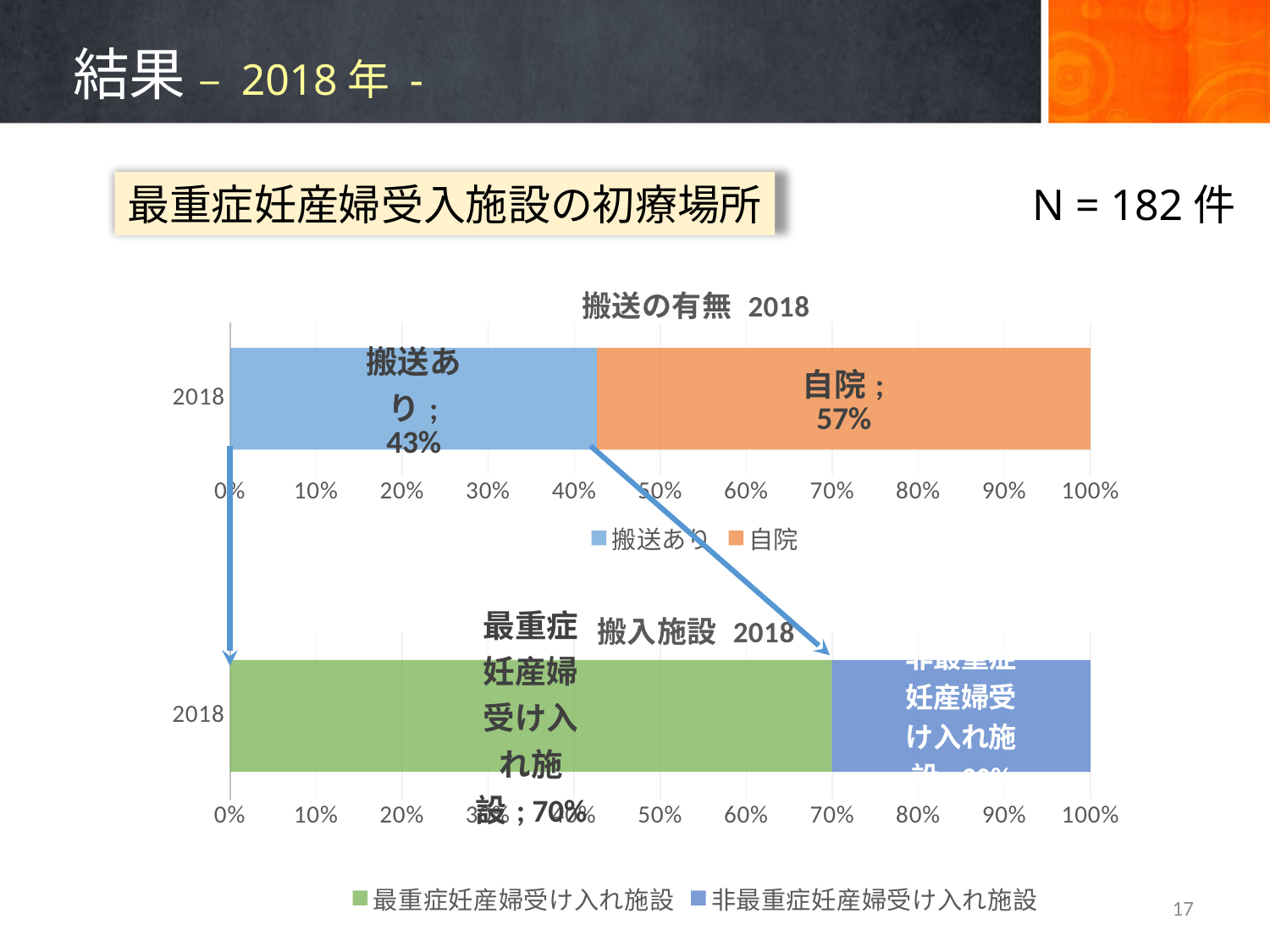
In the top chart titled 搬送の有無 2018, what is the difference between the 自院 and 搬送あり values? 14% In the top chart titled 搬送の有無 2018, which segment is larger, 搬送あり or 自院? 自院 In the top chart titled 搬送の有無 2018, how many series does the legend list? 2 In the bottom chart titled 搬入施設 2018, is the value for 非最重症妊産婦受け入れ施設 greater or less than 40%? less What kind of chart is the top chart titled 搬送の有無 2018? Stacked bar chart In the bottom chart titled 搬入施設 2018, what is the value for 最重症妊産婦受け入れ施設? 70% In the top chart titled 搬送の有無 2018, what is the value for 自院? 57% In the bottom chart titled 搬入施設 2018, which segment is larger, 最重症妊産婦受け入れ施設 or 非最重症妊産婦受け入れ施設? 最重症妊産婦受け入れ施設 In the bottom chart titled 搬入施設 2018, what colour is the 最重症妊産婦受け入れ施設 segment? Green In the bottom chart titled 搬入施設 2018, how many series does the legend list? 2 In the top chart titled 搬送の有無 2018, what colour is the 自院 segment? Orange In the top chart titled 搬送の有無 2018, what is the value for 搬送あり? 43%